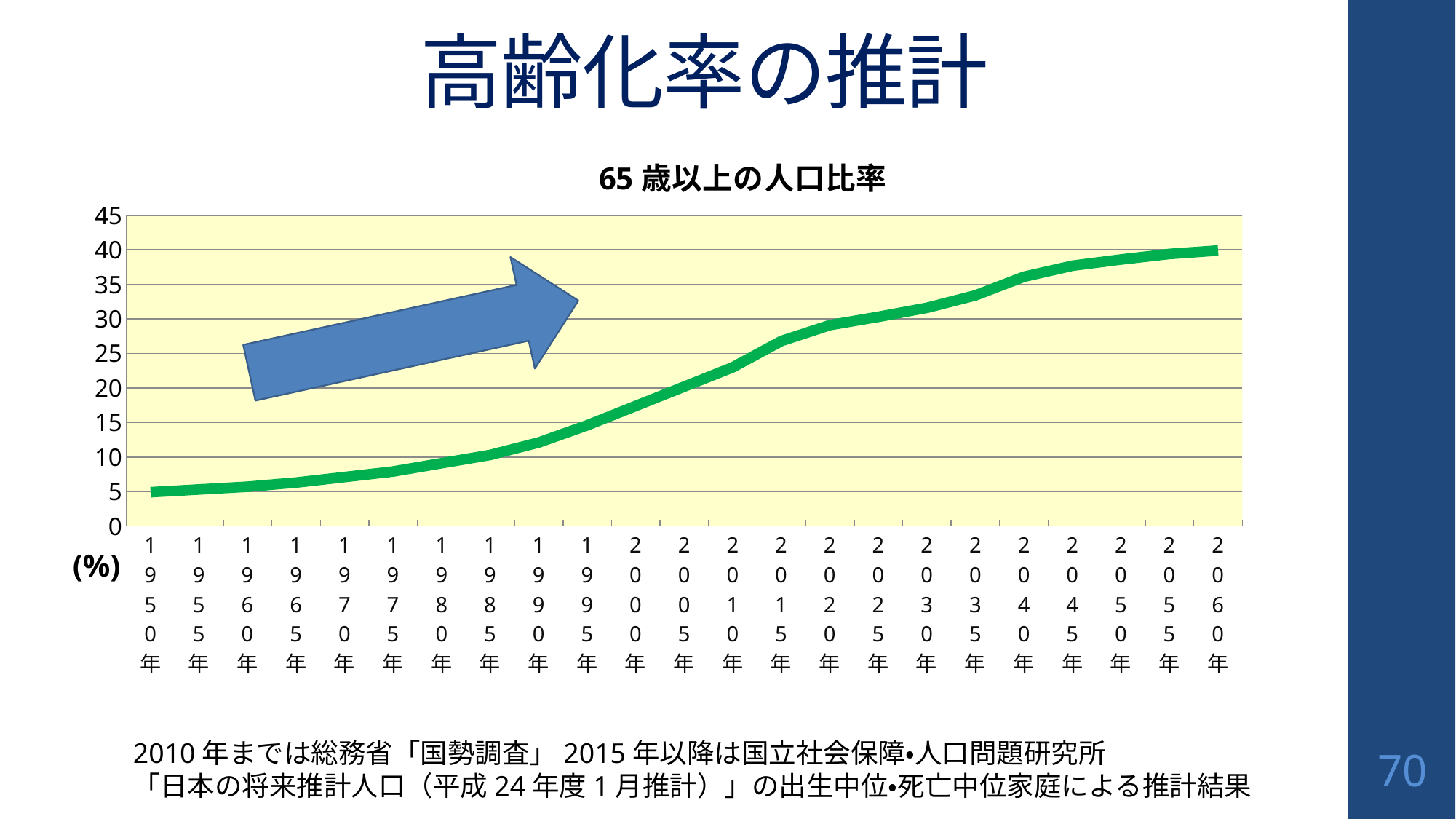
Which year has the lowest value on the chart? 1950年 How many years (data points) are plotted along the x axis? 23 Is the value for 2010年 greater or less than 20? greater What is the title of the chart? 65 歳以上の人口比率 Is the value for 1950年 greater or less than 10? less Is the value for 2060年 greater or less than 35? greater What unit is shown for the y axis of the chart? (%) Which year has the highest value on the chart? 2060年 What kind of chart is shown on the slide? line chart Which is larger, the value for 1990年 or the value for 2010年? 2010年 Do the values rise or fall from 1950年 to 2060年? rise